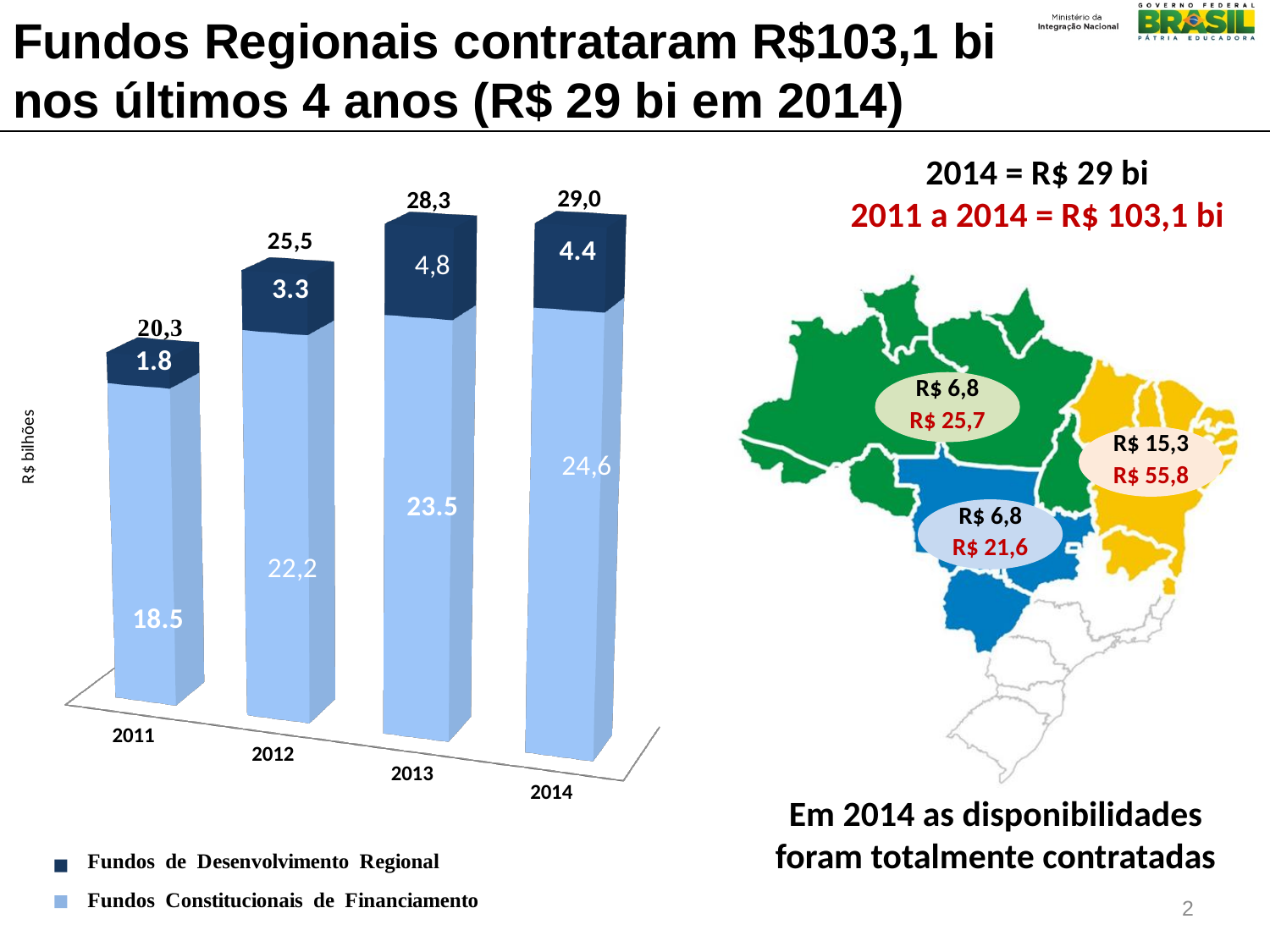
What is the unit label on the vertical axis of the bar chart? R$ bilhões What type of chart is shown on the left of the slide? Stacked bar chart What is the value for Fundos de Desenvolvimento Regional in 2013? 4,8 Do the bar totals rise or fall from 2011 to 2014? Rise How many years are shown on the x axis of the bar chart? 4 What is the total shown above the 2012 bar? 25,5 What is the value for Fundos Constitucionais de Financiamento in 2014? 24,6 Which year has the highest total in the bar chart? 2014 Which year has the lowest total in the bar chart? 2011 How many series does the legend of the bar chart list? 2 What is the value for Fundos Constitucionais de Financiamento in 2011? 18.5 Which year has the larger value for Fundos de Desenvolvimento Regional, 2013 or 2014? 2013